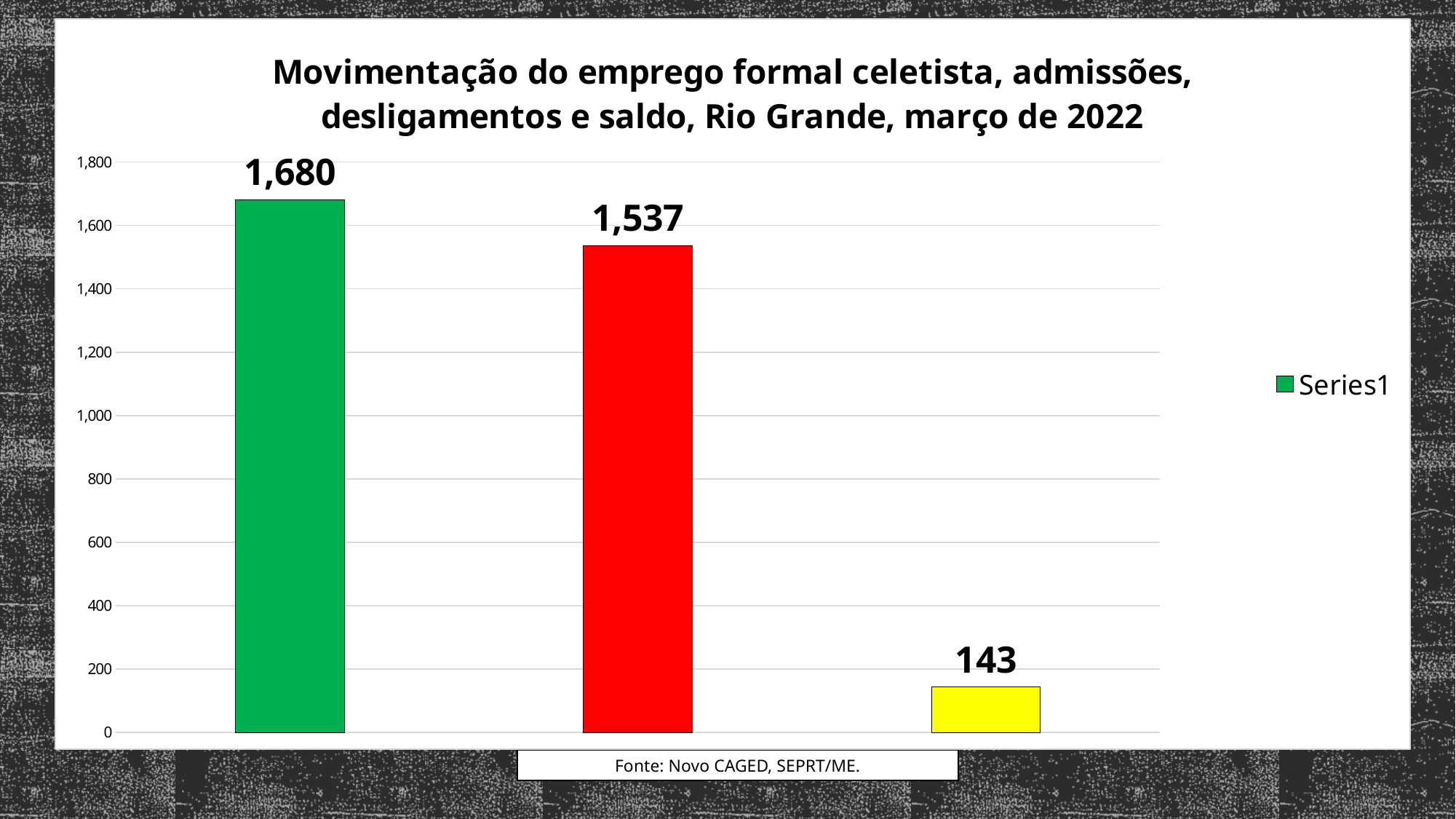
What is the value shown on the green bar (the first bar from the left)? 1,680 What is the difference between the red bar's value and the yellow bar's value? 1,394 What is the value shown on the yellow bar (the rightmost bar)? 143 Which is larger, the value of the green bar or the value of the red bar? The green bar What is the difference between the green bar's value and the red bar's value? 143 Which bar has the highest value? The green bar (first from the left), 1,680 What kind of chart is shown on the slide? Bar chart Which bar has the lowest value? The yellow bar (rightmost), 143 What is the value shown on the red bar (the middle bar)? 1,537 How many bars are plotted in the chart? 3 How many series does the legend list? 1 Is the value of the yellow bar greater or less than 200? less